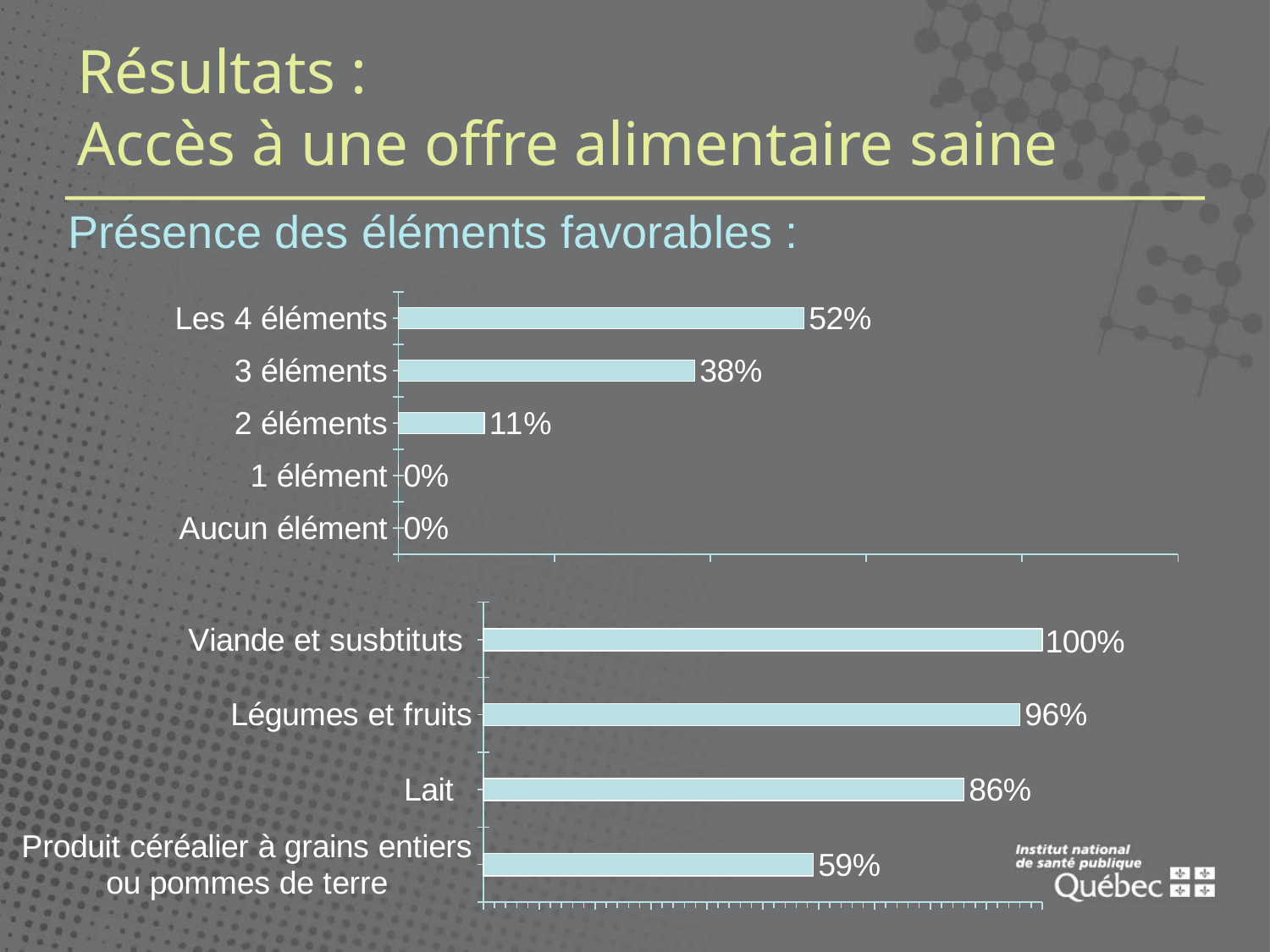
What type of chart is the bottom chart? Bar chart In the bottom chart, which is larger: 'Lait' or 'Produit céréalier à grains entiers ou pommes de terre'? Lait In the top chart, how many categories are shown? 5 In the bottom chart, which category has the highest value? Viande et susbtituts In the top chart, what is the difference between 'Les 4 éléments' and '3 éléments'? 14% In the bottom chart, what is the value for 'Lait'? 86% In the bottom chart, what is the difference between 'Légumes et fruits' and 'Lait'? 10% In the bottom chart, which category has the lowest value? Produit céréalier à grains entiers ou pommes de terre In the top chart, what is the value for '1 élément'? 0% In the top chart, what is the value for '2 éléments'? 11% In the top chart, what is the value for 'Les 4 éléments'? 52% In the top chart, which category has the highest value? Les 4 éléments